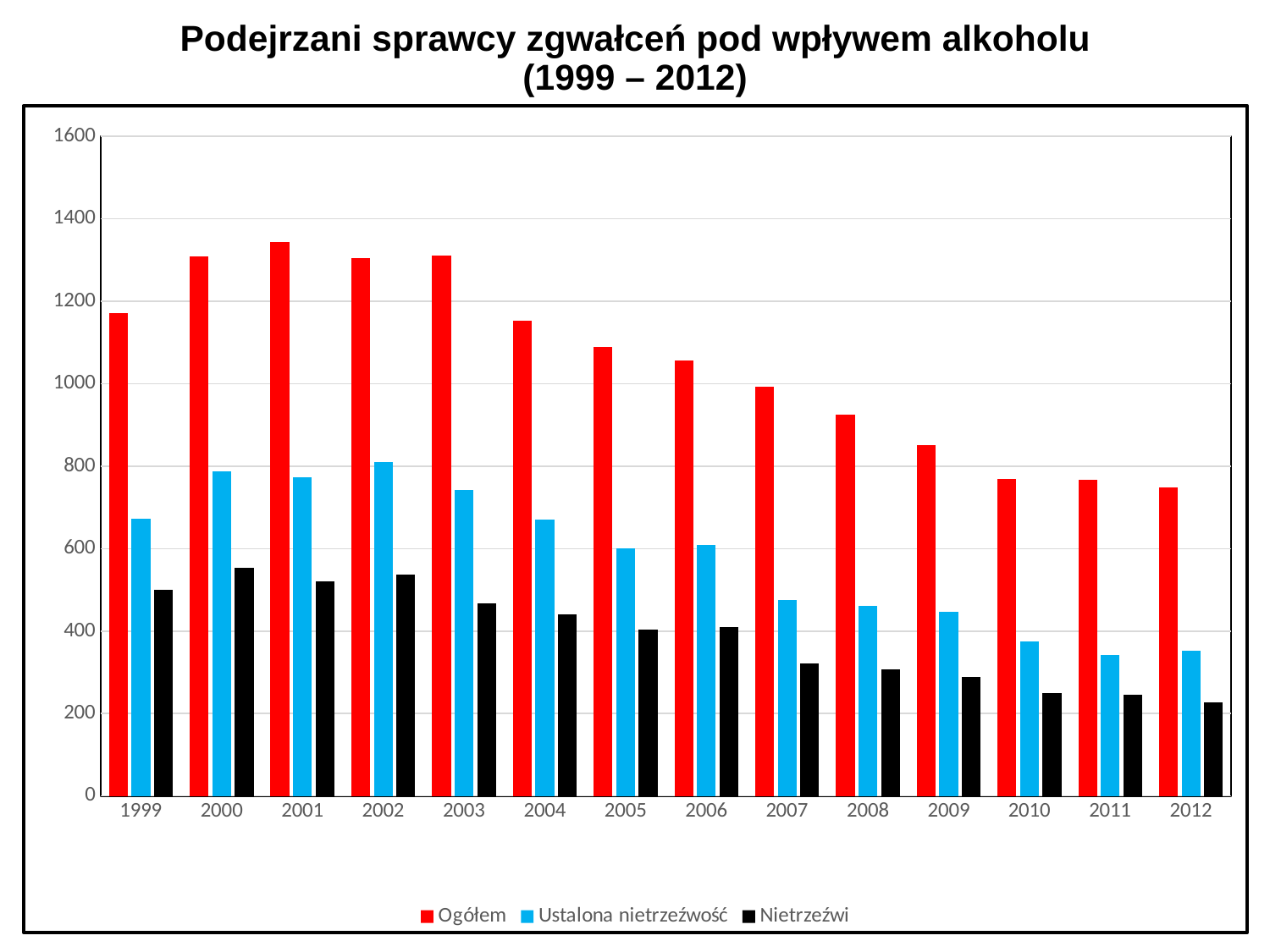
How many years are shown on the x axis? 14 Which colour represents the Ogółem series in the legend? red Is the value for Nietrzeźwi in 2000 greater or less than 400? greater Is the value for Nietrzeźwi in 2012 greater or less than 400? less What kind of chart is shown on the slide? bar chart Is the value for Ogółem in 2012 greater or less than 800? less Which year has the highest value for Ogółem? 2001 How many series does the legend list? 3 Does the Ogółem series generally rise or fall from 2003 to 2012? fall Which is larger: Ogółem in 2000 or Ogółem in 2009? 2000